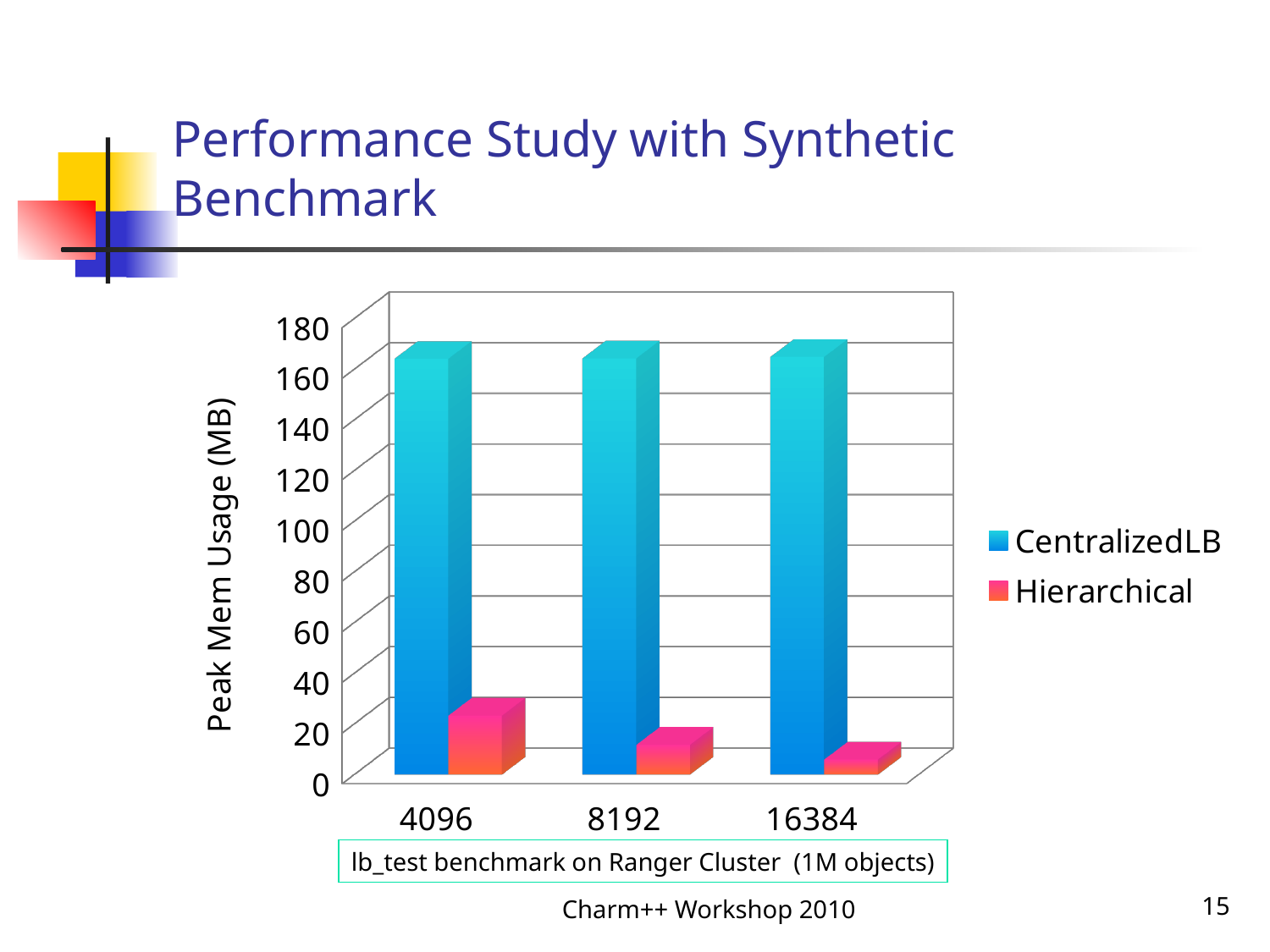
Is the Hierarchical value for 4096 greater or less than 40? less Is the CentralizedLB value for 4096 greater or less than 140? greater Which series is shown in blue in the chart's legend? CentralizedLB What is the label of the chart's vertical axis? Peak Mem Usage (MB) For the Hierarchical series, which category has the highest value? 4096 How many categories are shown on the x axis of the chart? 3 Which series has the larger value at 8192, CentralizedLB or Hierarchical? CentralizedLB Is the CentralizedLB value for 16384 greater or less than 160? greater What kind of chart is shown on the slide? bar chart Do the Hierarchical values rise or fall as the x-axis values increase from 4096 to 16384? fall How many series does the chart's legend list? 2